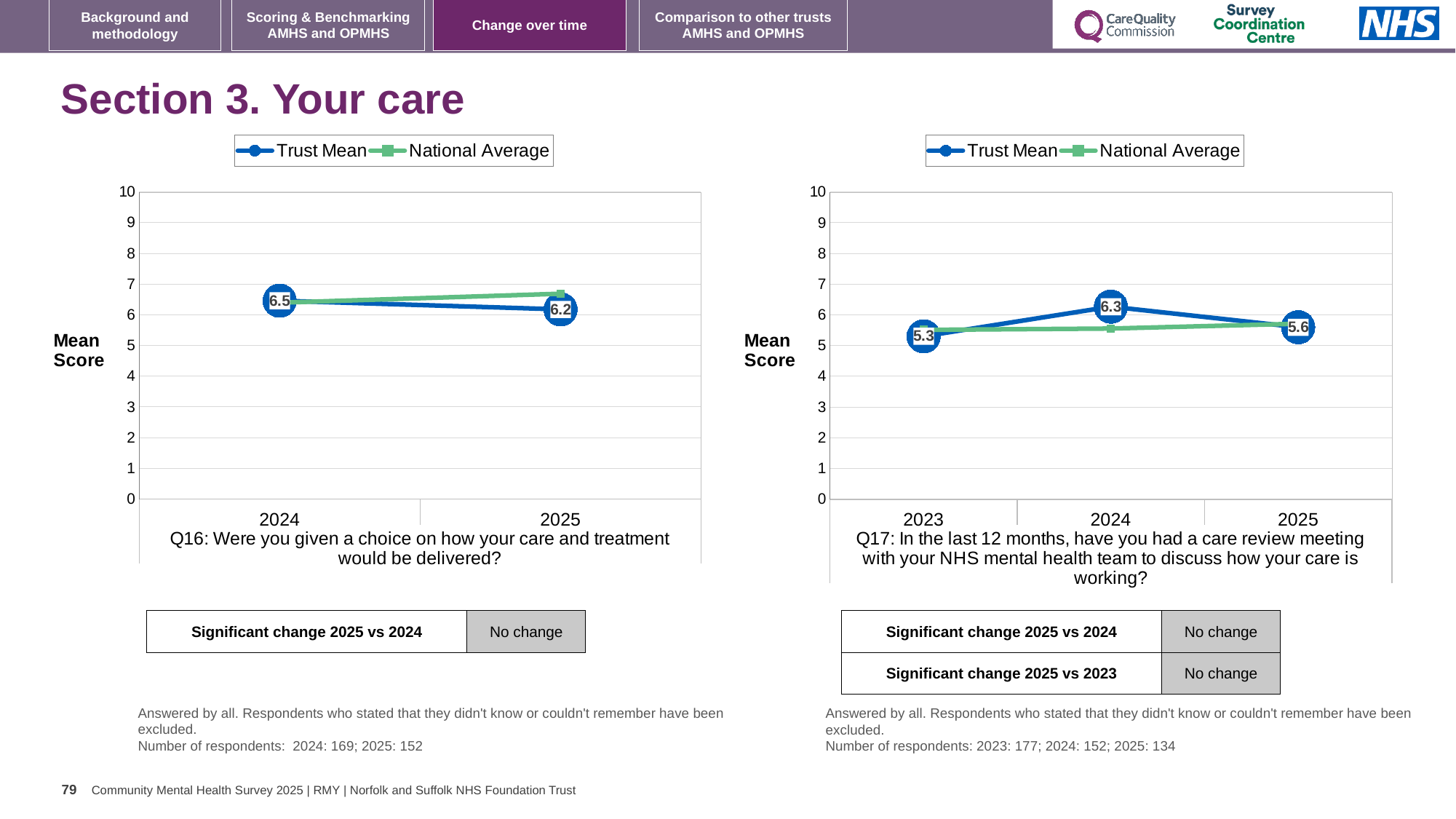
How many years are plotted on the Q17 chart? 3 In the Q17 chart, which year has the highest Trust Mean? 2024 In the Q16 chart, does the Trust Mean rise or fall from 2024 to 2025? fall In the Q16 chart, what is the Trust Mean for 2024? 6.5 In the Q17 chart, what is the Trust Mean for 2023? 5.3 In the Q16 chart, what is the Trust Mean for 2025? 6.2 In the Q17 chart, which year has the lowest Trust Mean? 2023 In the Q16 chart, is the National Average for 2025 greater or less than 6? greater In the Q17 chart, what is the difference between the Trust Mean for 2024 and 2023? 1.0 In the Q17 chart, what is the Trust Mean for 2024? 6.3 In the Q17 chart, is the Trust Mean or the National Average higher in 2024? Trust Mean How many series does the legend of the Q16 chart list? 2